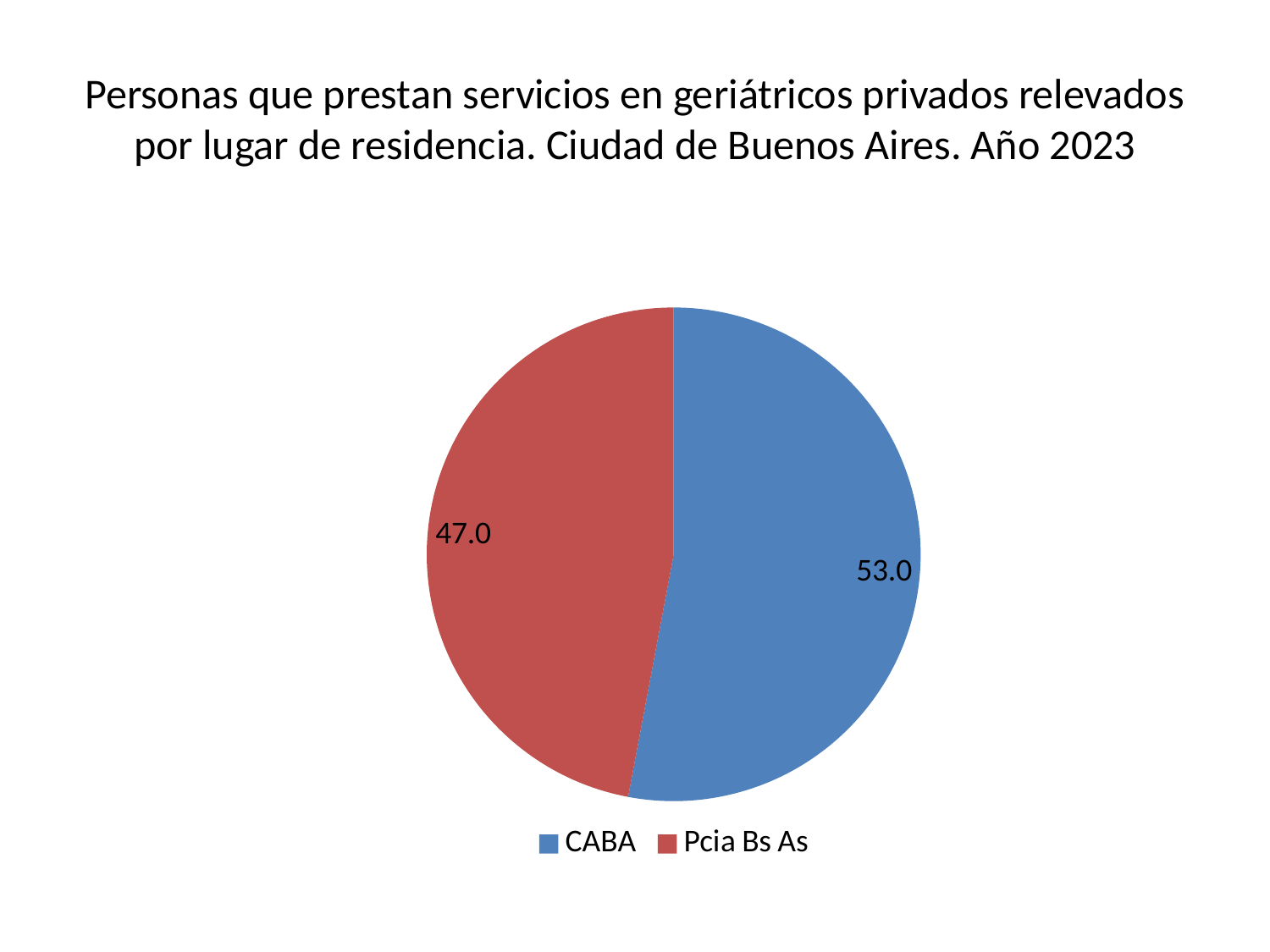
What is the value for Pcia Bs As? 47.0 Which category has the largest slice? CABA How many entries does the legend list? 2 How many slices does the pie chart have? 2 What colour is the slice for Pcia Bs As? Red Which is larger, the value for CABA or the value for Pcia Bs As? CABA Which category has the smallest slice? Pcia Bs As What is the value for CABA? 53.0 What year does the chart title refer to? 2023 What kind of chart is shown on the slide? Pie chart What is the difference between the values for CABA and Pcia Bs As? 6.0 What is the total of the two slice values? 100.0